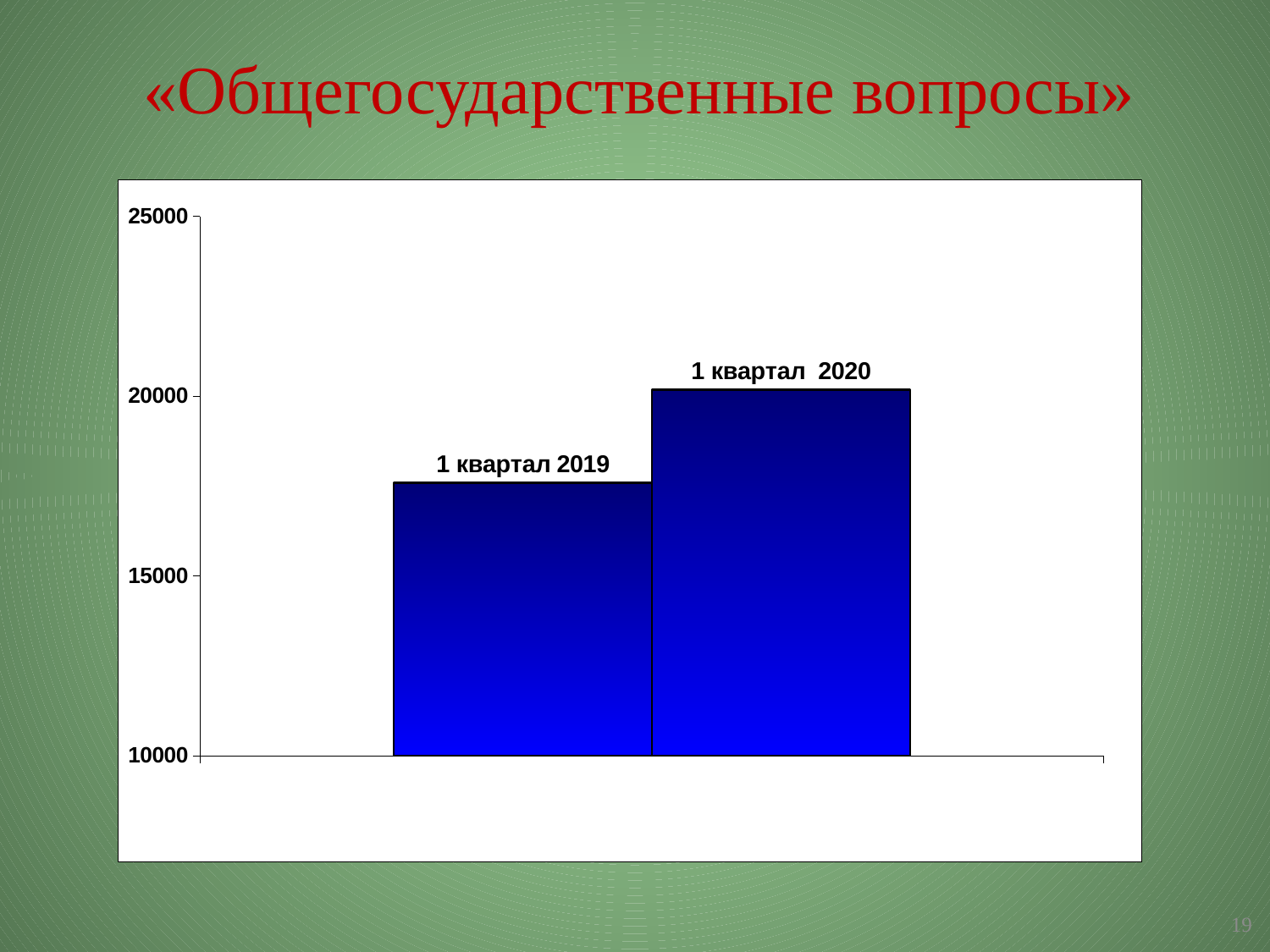
Which category has the lowest value? 1 квартал 2019 Is the value for 1 квартал 2019 greater or less than 20000? less How many bars are plotted in the chart? 2 Which is larger, the value for 1 квартал 2019 or the value for 1 квартал 2020? 1 квартал 2020 What kind of chart is shown on the slide? bar chart Do the values rise or fall from 1 квартал 2019 to 1 квартал 2020? rise What is the lowest value shown on the vertical axis? 10000 Is the value for 1 квартал 2019 greater or less than 15000? greater Which category has the highest value? 1 квартал 2020 What is the title of the slide above the chart? «Общегосударственные вопросы» Is the value for 1 квартал 2020 greater or less than 25000? less